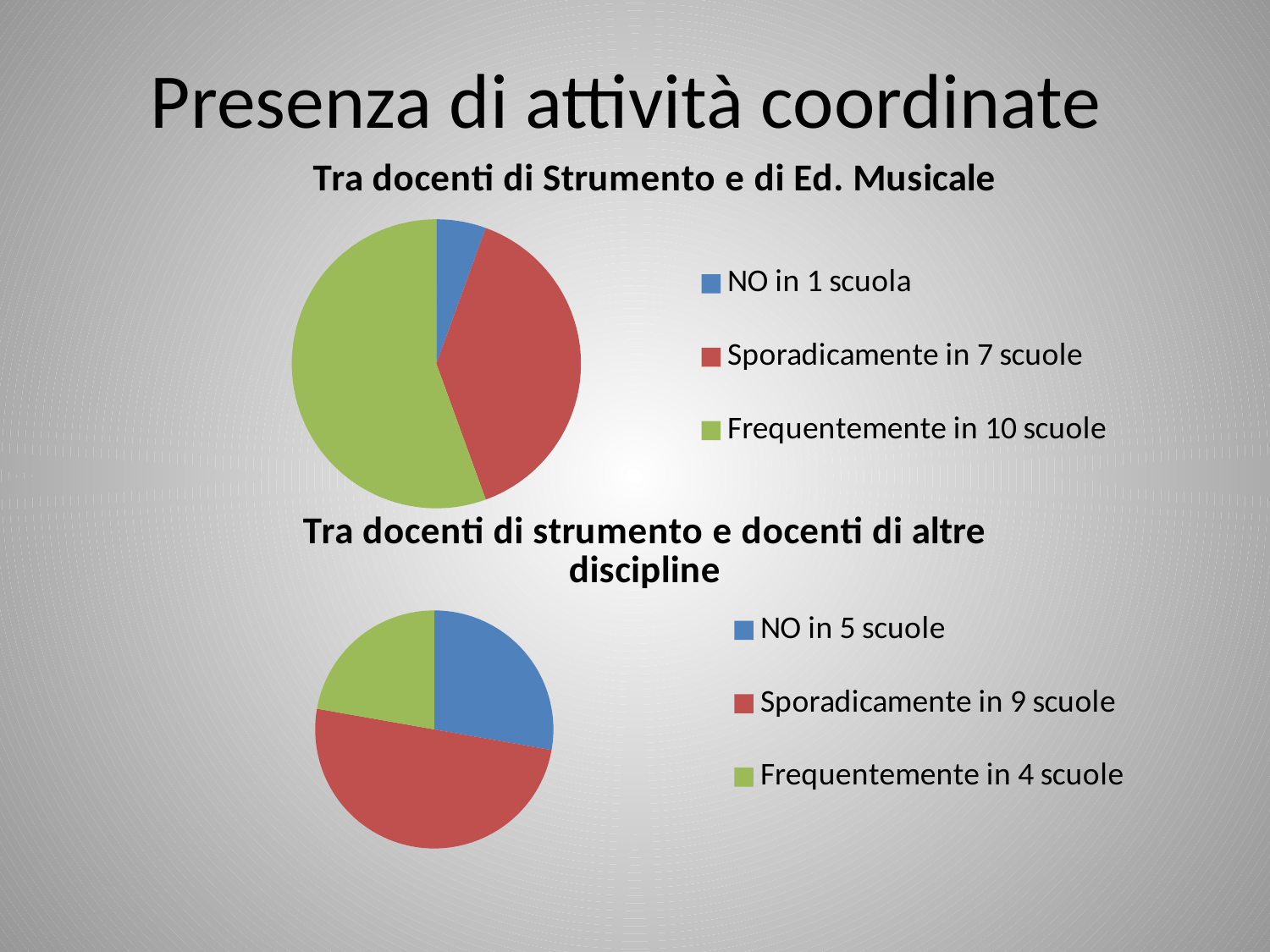
In the chart 'Tra docenti di Strumento e di Ed. Musicale', in how many schools do coordinated activities happen frequently (Frequentemente)? 10 scuole In the chart 'Tra docenti di Strumento e di Ed. Musicale', which category has the largest slice? Frequentemente in 10 scuole In the chart 'Tra docenti di Strumento e di Ed. Musicale', how many more schools are in the 'Frequentemente' category than in the 'Sporadicamente' category? 3 In the chart 'Tra docenti di Strumento e di Ed. Musicale', in how many schools is the answer NO? 1 scuola In the bottom pie chart, what colour represents the 'Sporadicamente' category? Red In the chart 'Tra docenti di Strumento e di Ed. Musicale', which category has the smallest slice? NO in 1 scuola In the chart 'Tra docenti di strumento e docenti di altre discipline', which is larger: the 'NO' slice or the 'Frequentemente' slice? NO In the chart 'Tra docenti di strumento e docenti di altre discipline', which category has the largest slice? Sporadicamente in 9 scuole In the chart 'Tra docenti di strumento e docenti di altre discipline', what is the total number of schools across all three categories? 18 How many slices does the pie chart 'Tra docenti di strumento e docenti di altre discipline' have? 3 In the chart 'Tra docenti di strumento e docenti di altre discipline', in how many schools do coordinated activities happen sporadically (Sporadicamente)? 9 scuole What kind of chart is used for 'Tra docenti di Strumento e di Ed. Musicale'? Pie chart